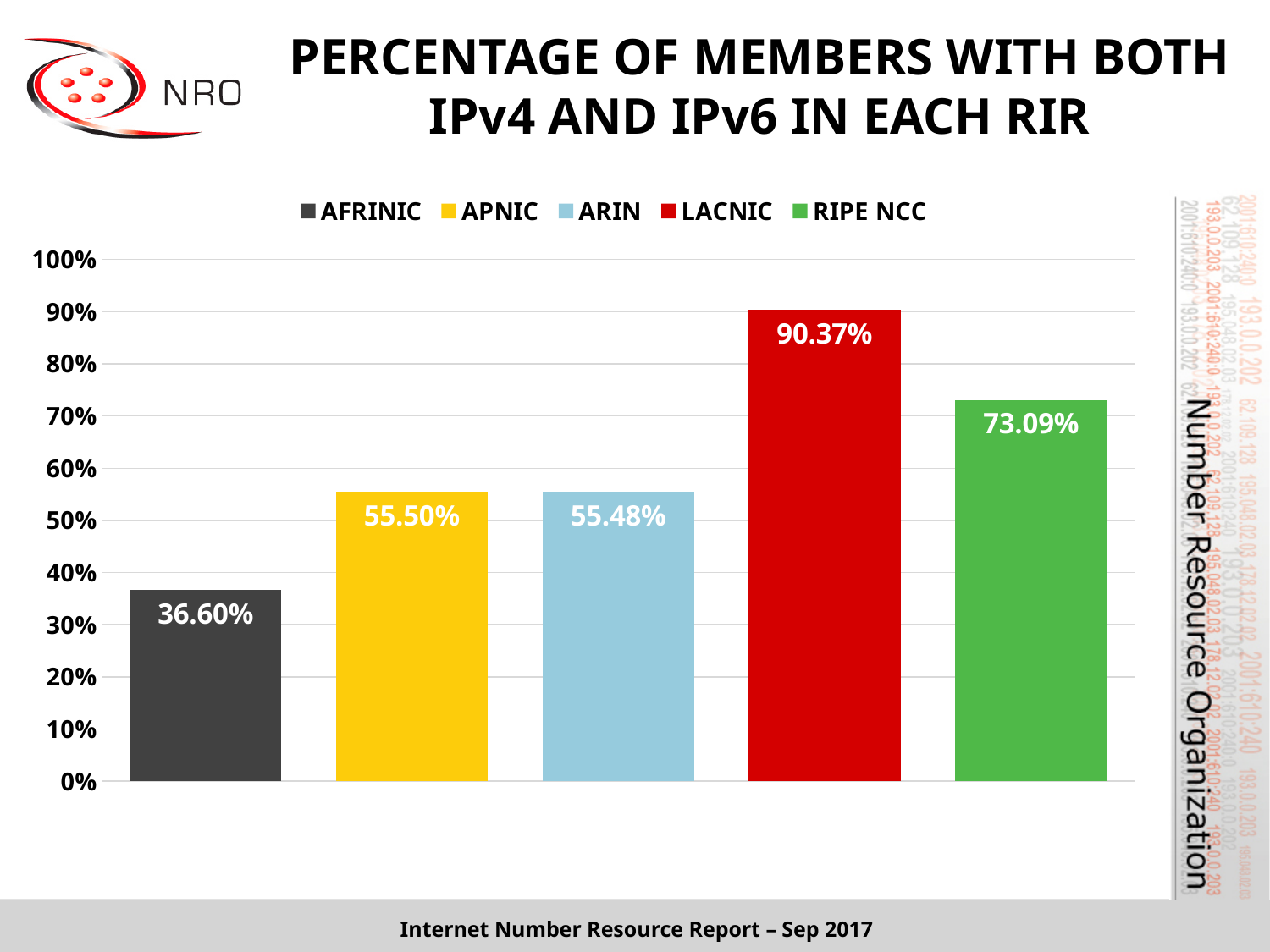
What is the difference between the LACNIC and RIPE NCC values? 17.28% What is the value shown for APNIC? 55.50% What is the difference between the APNIC and AFRINIC values? 18.90% What kind of chart is shown on the slide? Bar chart What is the value shown for AFRINIC? 36.60% What colour is the bar for LACNIC? Red Which RIR has the highest percentage of members with both IPv4 and IPv6? LACNIC What is the value shown for RIPE NCC? 73.09% How many RIRs are shown in the chart? 5 Which is larger, the value for RIPE NCC or the value for ARIN? RIPE NCC What percentage of LACNIC members have both IPv4 and IPv6? 90.37% Which RIR has the lowest percentage of members with both IPv4 and IPv6? AFRINIC